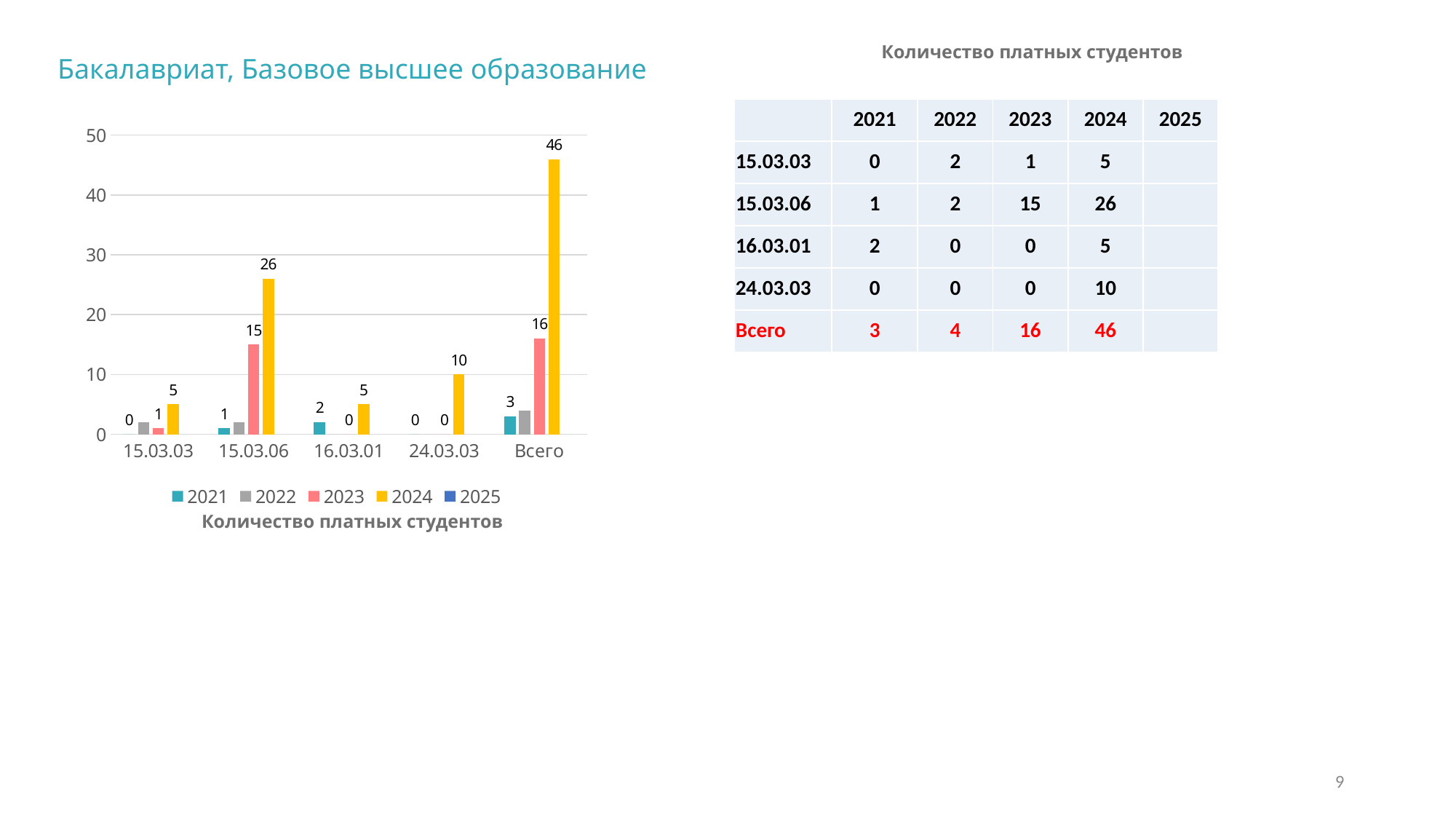
How many categories are shown on the x axis? 5 What kind of chart is shown on the slide? bar chart Among the program categories (excluding Всего), which has the highest 2024 value? 15.03.06 Which category has the highest value for the 2024 series? Всего What is the value for 2023 in the Всего category? 16 Which is larger: the 2024 value for 15.03.03 or the 2024 value for 24.03.03? 24.03.03 Is the 2024 value for Всего greater or less than 40? greater What is the value for 2024 in the 24.03.03 category? 10 What is the value for 2021 in the 16.03.01 category? 2 What is the difference between the 2024 and 2023 values in the Всего category? 30 What is the value for 2024 in the 15.03.06 category? 26 How many series does the legend list? 5